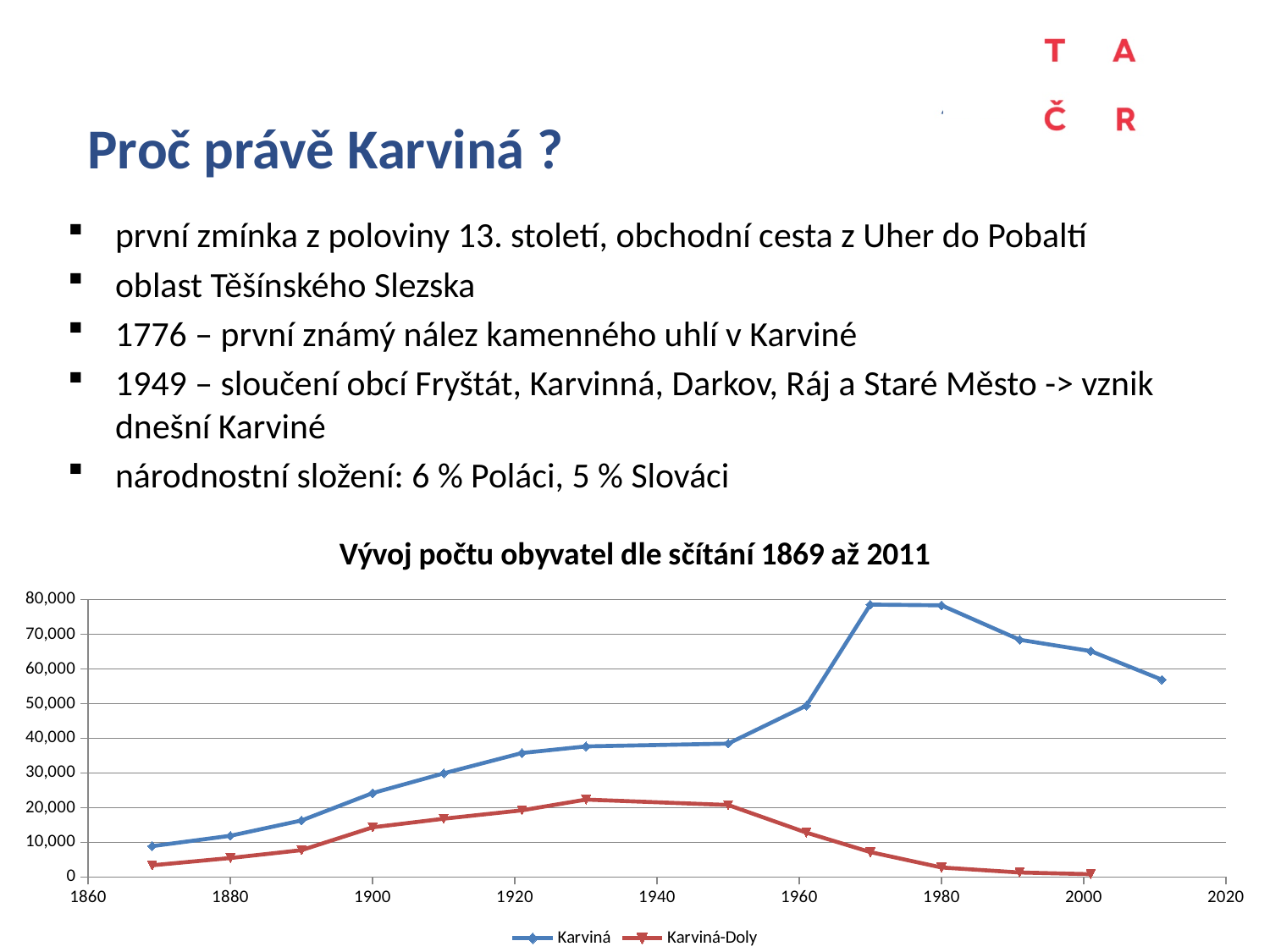
Does the Karviná-Doly series rise or fall between 1930 and 2001? fall What is the title of the chart? Vývoj počtu obyvatel dle sčítání 1869 až 2011 Does the Karviná series rise or fall between 1869 and 1970? rise Is the value for Karviná around 1970 greater or less than 70,000? greater Is the value for Karviná-Doly around 1961 greater or less than 10,000? greater Which series has the larger value in 1950, Karviná or Karviná-Doly? Karviná Is the value for Karviná in 2011 greater or less than 60,000? less Which series is drawn in red on the chart? Karviná-Doly What kind of chart is shown on the slide? line chart How many series does the chart legend list? 2